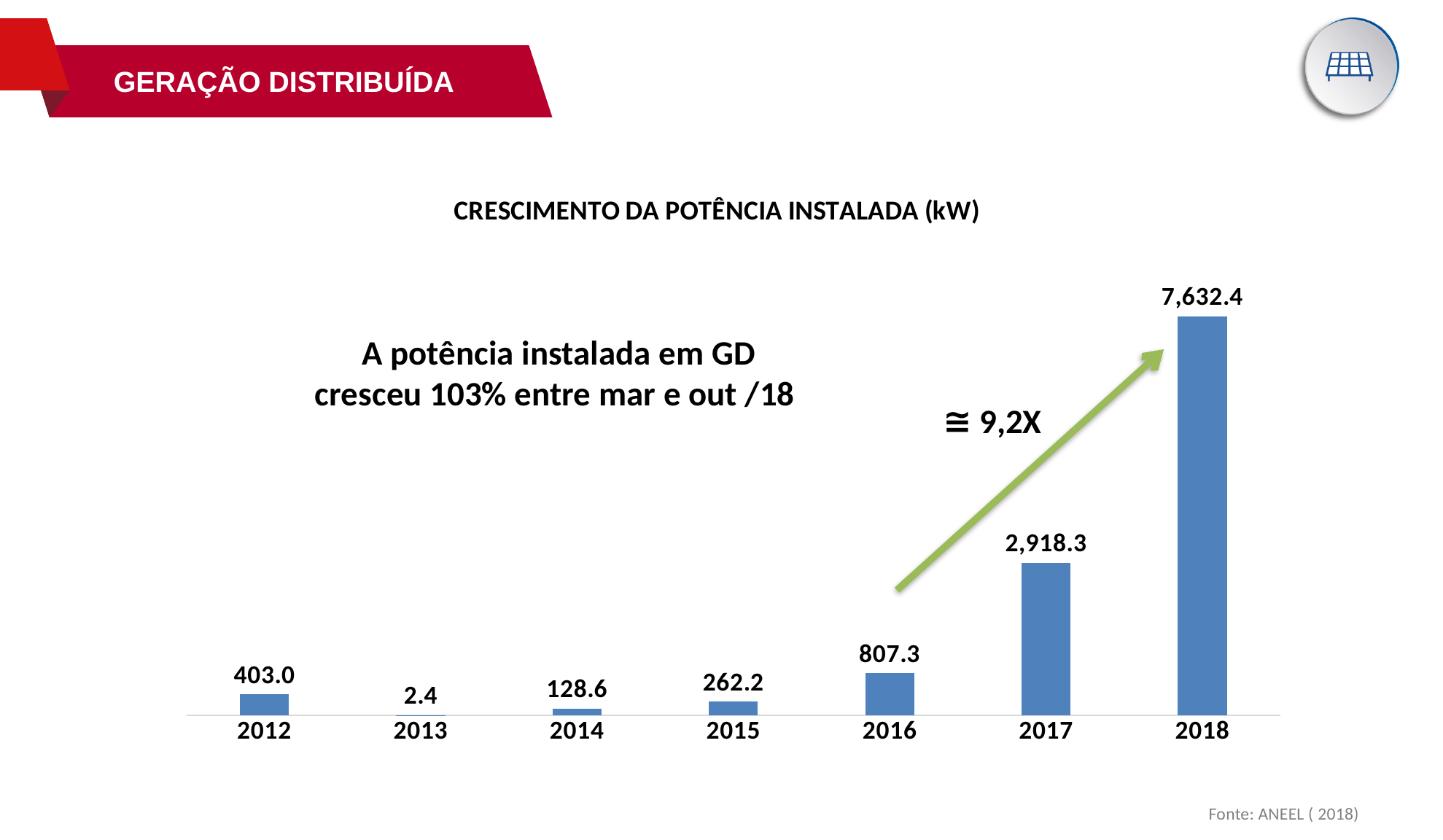
What is the title of the chart? CRESCIMENTO DA POTÊNCIA INSTALADA (kW) Which year has the lowest value? 2013 How many years are shown on the x axis? 7 What kind of chart is this? bar chart Which is larger, the value for 2012 or the value for 2015? 2012 What is the value for 2016? 807.3 What is the difference between the values for 2015 and 2014? 133.6 What is the value for 2013? 2.4 Which year has the highest value? 2018 What is the value for 2018? 7,632.4 What is the difference between the values for 2018 and 2017? 4,714.1 What is the value for 2012? 403.0